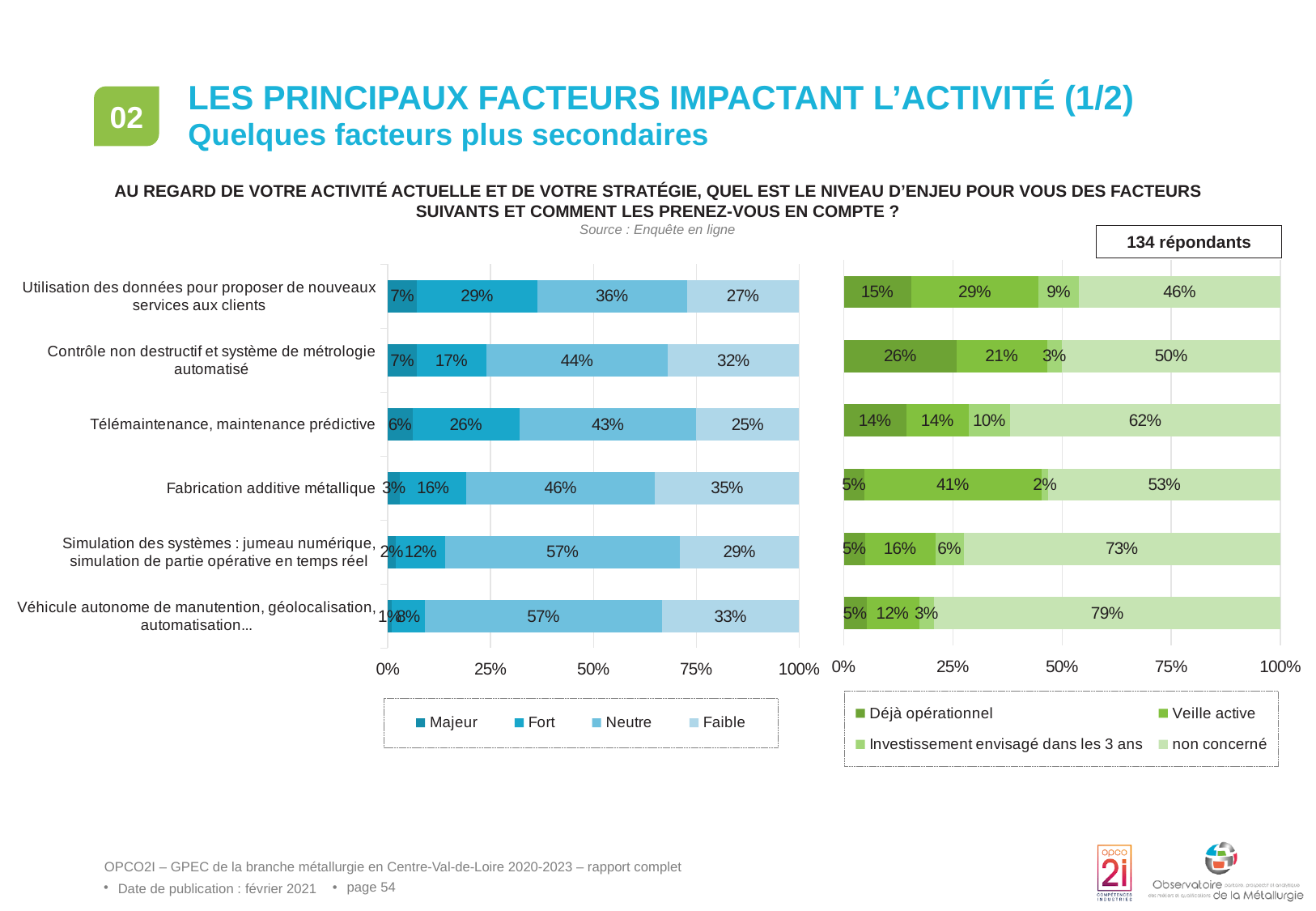
On the right chart, which category has the highest 'Veille active' value? Fabrication additive métallique How many categories does the left chart show? 6 On the left chart, what is the 'Neutre' value for 'Simulation des systèmes : jumeau numérique, simulation de partie opérative en temps réel'? 57% What kind of chart is the left chart? Stacked bar chart On the left chart, which is larger: the 'Faible' value for 'Fabrication additive métallique' or for 'Télémaintenance, maintenance prédictive'? Fabrication additive métallique How many series does the legend of the right chart list? 4 On the left chart, what is the 'Fort' value for 'Utilisation des données pour proposer de nouveaux services aux clients'? 29% On the right chart, what is the 'Déjà opérationnel' value for 'Contrôle non destructif et système de métrologie automatisé'? 26% How many respondents does the slide indicate? 134 répondants On the left chart, which category has the lowest 'Majeur' value? Véhicule autonome de manutention, géolocalisation, automatisation… On the right chart, what is the difference between the 'non concerné' values for 'Simulation des systèmes : jumeau numérique, simulation de partie opérative en temps réel' and 'Utilisation des données pour proposer de nouveaux services aux clients'? 27% On the right chart, what is the 'non concerné' value for 'Véhicule autonome de manutention, géolocalisation, automatisation…'? 79%